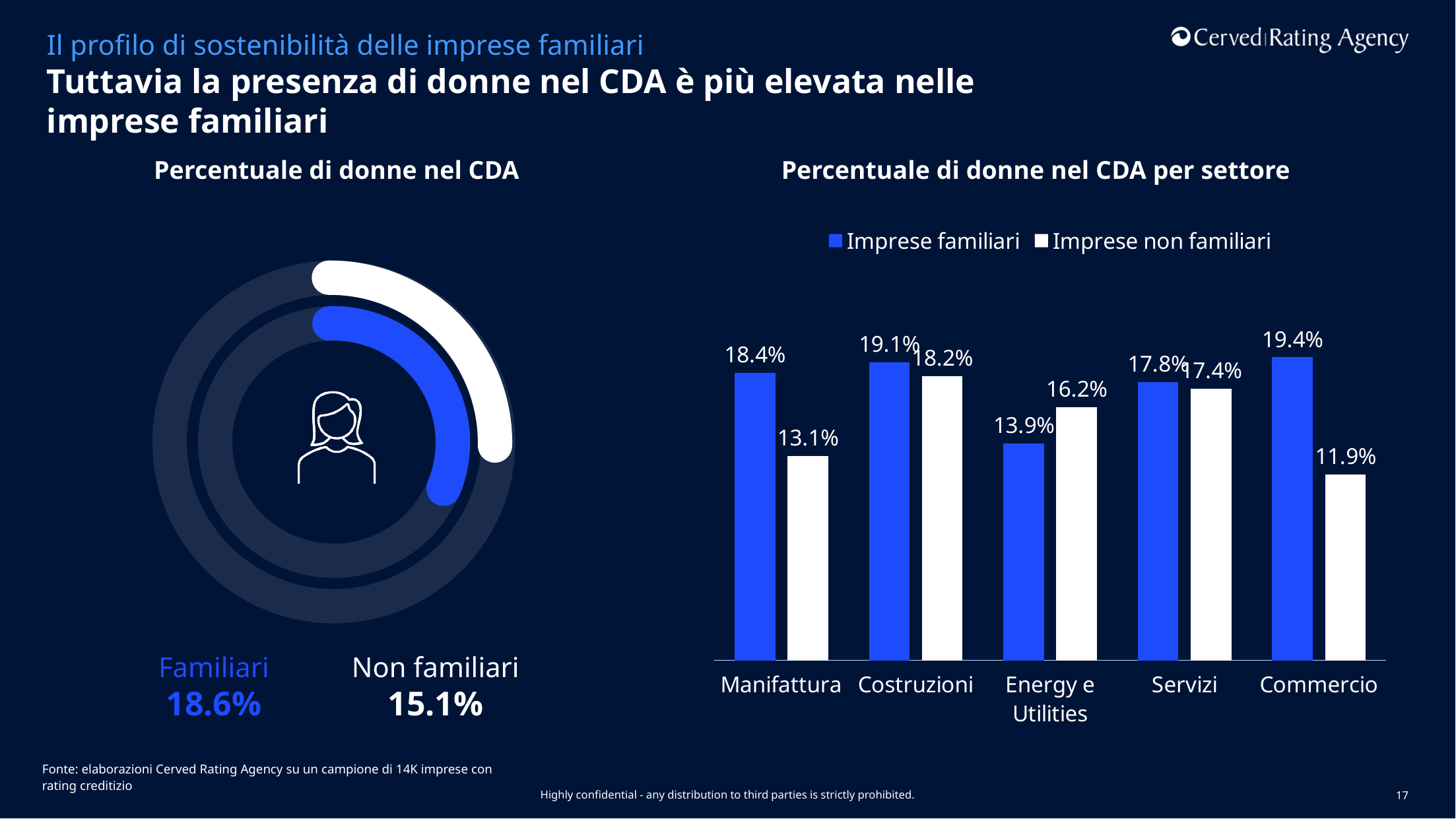
In the chart 'Percentuale di donne nel CDA', what is the difference between Familiari and Non familiari? 3.5% In the chart 'Percentuale di donne nel CDA per settore', which is larger in Energy e Utilities: Imprese familiari or Imprese non familiari? Imprese non familiari In the chart 'Percentuale di donne nel CDA per settore', which sector has the lowest value for Imprese non familiari? Commercio In the chart 'Percentuale di donne nel CDA per settore', what is the value for Imprese familiari in Commercio? 19.4% What kind of chart is 'Percentuale di donne nel CDA per settore'? Bar chart How many series does the legend of the chart 'Percentuale di donne nel CDA per settore' list? 2 In the chart 'Percentuale di donne nel CDA per settore', what is the difference between Imprese familiari and Imprese non familiari in Manifattura? 5.3% In the chart 'Percentuale di donne nel CDA', what is the value for Familiari? 18.6% In the chart 'Percentuale di donne nel CDA', what is the value for Non familiari? 15.1% In the chart 'Percentuale di donne nel CDA per settore', what is the value for Imprese non familiari in Energy e Utilities? 16.2% How many sectors are shown in the chart 'Percentuale di donne nel CDA per settore'? 5 In the chart 'Percentuale di donne nel CDA per settore', which sector has the highest value for Imprese familiari? Commercio